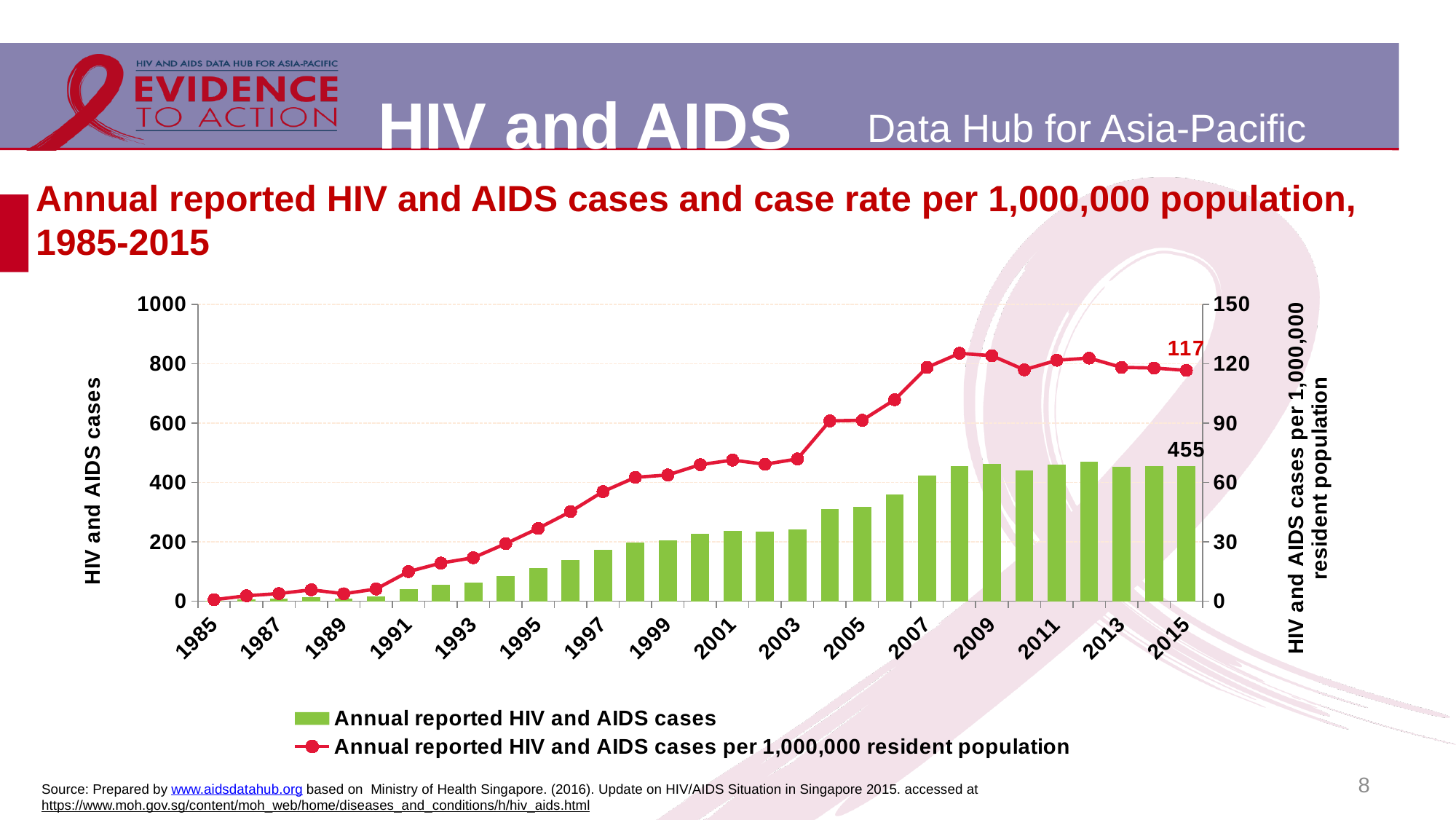
How many series does the legend list? 2 Is the case rate per 1,000,000 resident population for 1995 greater or less than 60? less What kind of chart is used to show the annual reported HIV and AIDS cases and the case rate? A bar chart combined with a line chart Do the annual reported HIV and AIDS cases generally rise or fall from 1985 to 2015? Rise Which year has more annual reported HIV and AIDS cases, 1995 or 2005? 2005 What is the annual reported HIV and AIDS case rate per 1,000,000 resident population shown for 2015? 117 What is the number of annual reported HIV and AIDS cases shown for 2015? 455 How many year labels are shown on the x axis? 16 Is the number of annual reported HIV and AIDS cases for 1995 greater or less than 200? less Is the case rate per 1,000,000 resident population for 2003 greater or less than 60? greater What is the title of the right-hand vertical axis? HIV and AIDS cases per 1,000,000 resident population